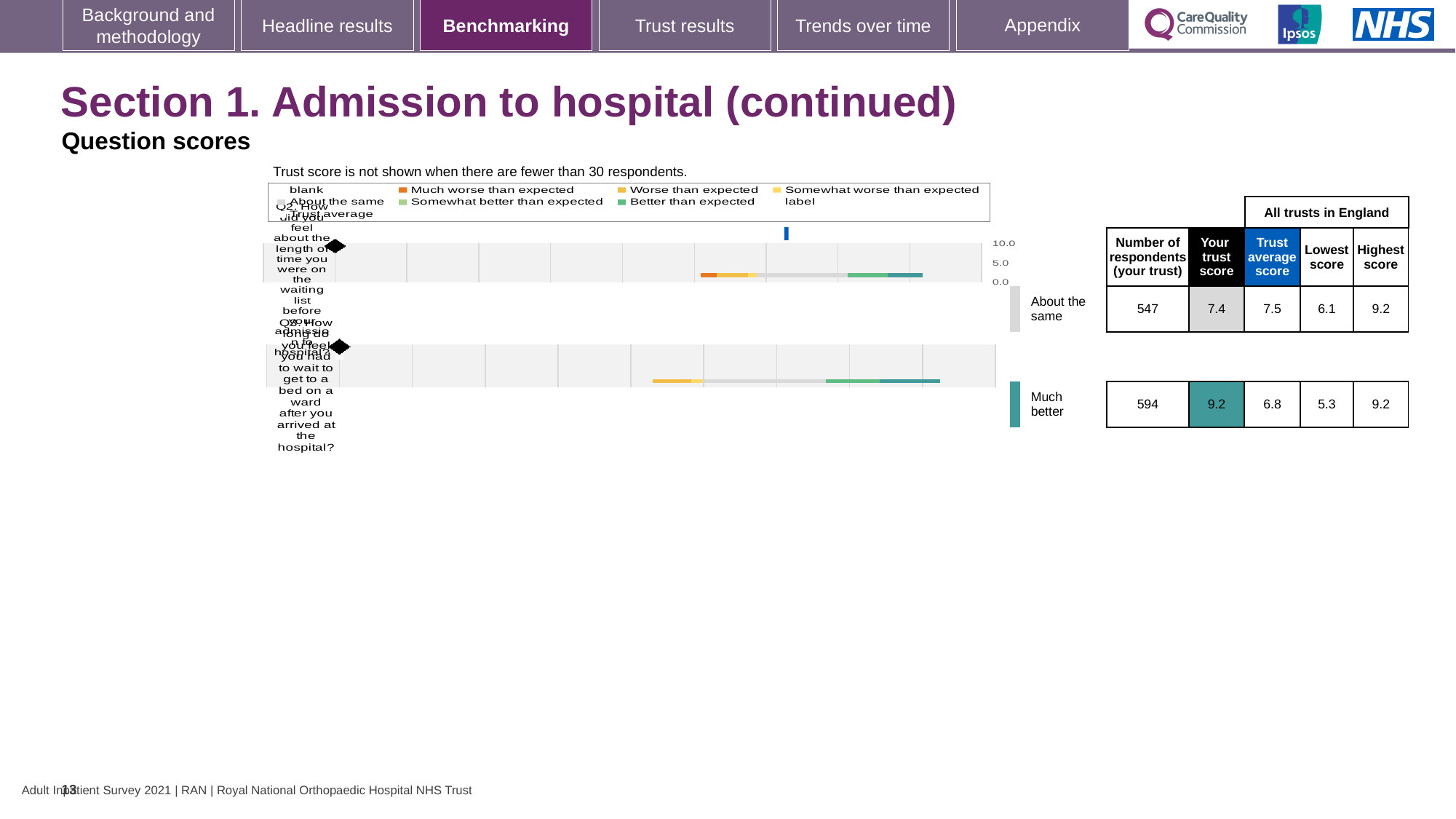
What is the difference between the highest and lowest scores across all trusts in England for Q2? 3.1 How many survey questions are plotted on the benchmarking chart? 2 Which question has the higher trust score, Q2 or Q3? Q3 What is the trust average score across all trusts in England for Q2? 7.5 Is the trust score for Q2 greater or less than 5.0 on the chart axis? greater What is the lowest score across all trusts in England for Q3? 5.3 What is the trust score for Q2 (how did you feel about the length of time you were on the waiting list before admission)? 7.4 How many respondents answered Q3 at this trust? 594 What is the difference between the trust score for Q3 and the trust average score for Q3? 2.4 What is the trust score for Q3 (how long did you feel you had to wait to get to a bed on a ward after you arrived at the hospital)? 9.2 What is the maximum value shown on the chart's horizontal axis? 10.0 What benchmarking category is shown for Q3? Much better